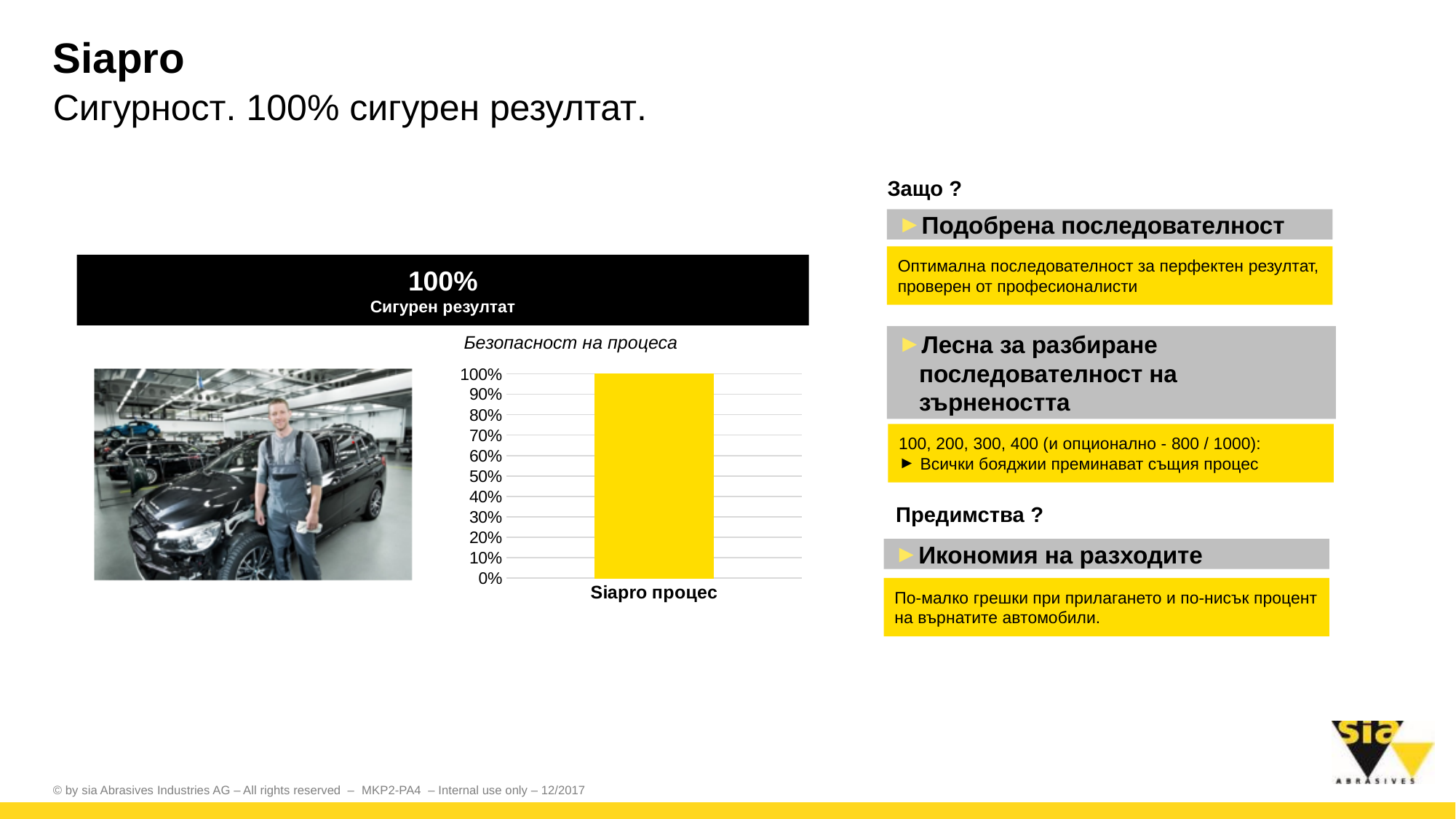
How many bars does the chart "Безопасност на процеса" contain? 1 What is the label of the category on the x axis of the chart? Siapro процес Is the value for "Siapro процес" greater or less than 50%? greater What kind of chart is shown under the heading "Безопасност на процеса"? bar chart Is the value for "Siapro процес" greater or less than 90%? greater What is the title of the chart on the slide? Безопасност на процеса What value does the bar for "Siapro процес" reach in the chart? 100%